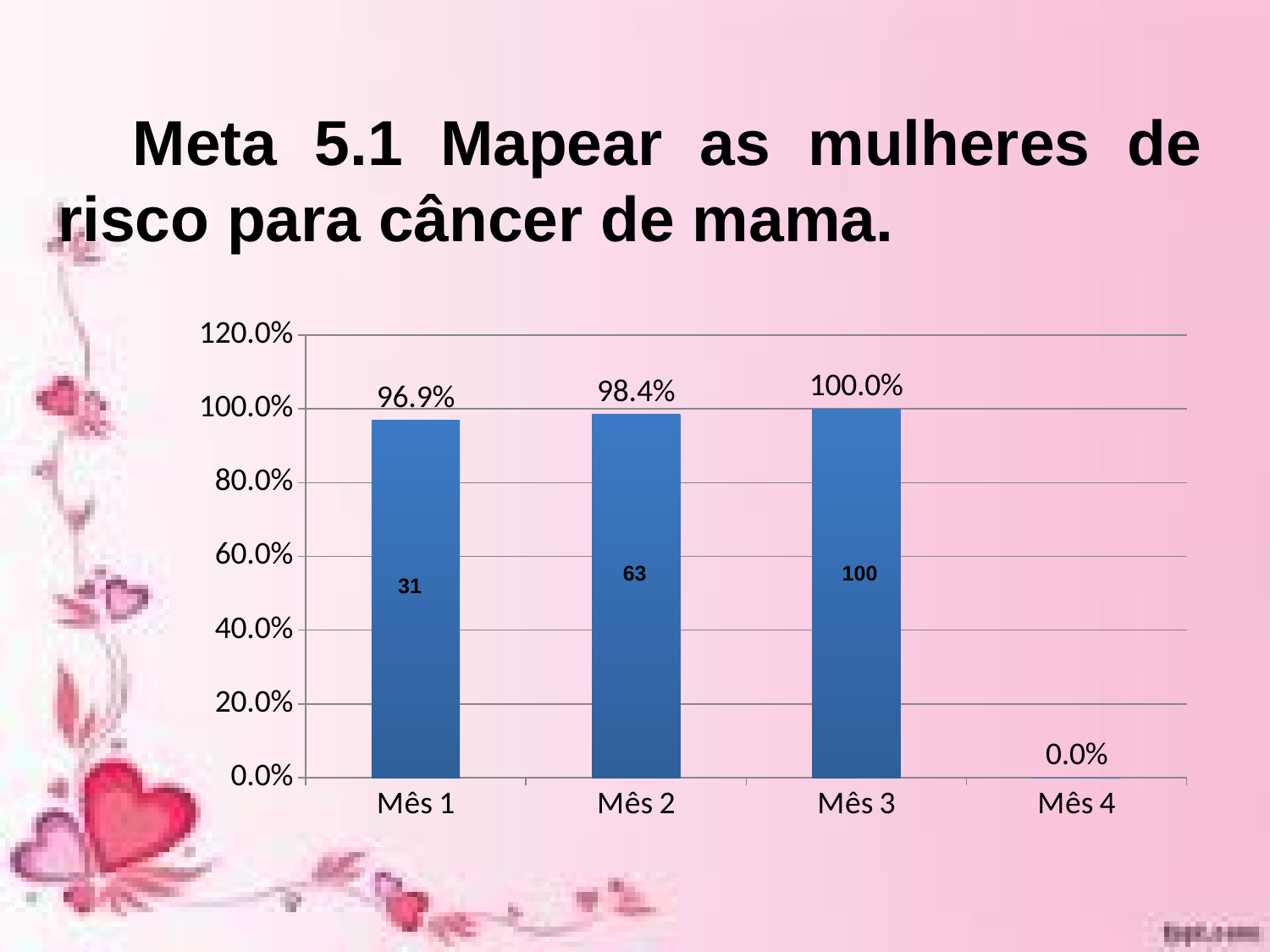
What is the value for Mês 2? 98.4% How many months are shown on the x axis? 4 What is the value for Mês 3? 100.0% What number is printed inside the bar for Mês 2? 63 Which is larger, the value for Mês 2 or the value for Mês 1? Mês 2 Which month has the highest value? Mês 3 What is the value for Mês 1? 96.9% Which month has the lowest value? Mês 4 What is the difference between the values for Mês 3 and Mês 1? 3.1% What is the value for Mês 4? 0.0% What kind of chart is shown on the slide? Bar chart What is the highest value shown on the vertical axis? 120.0%